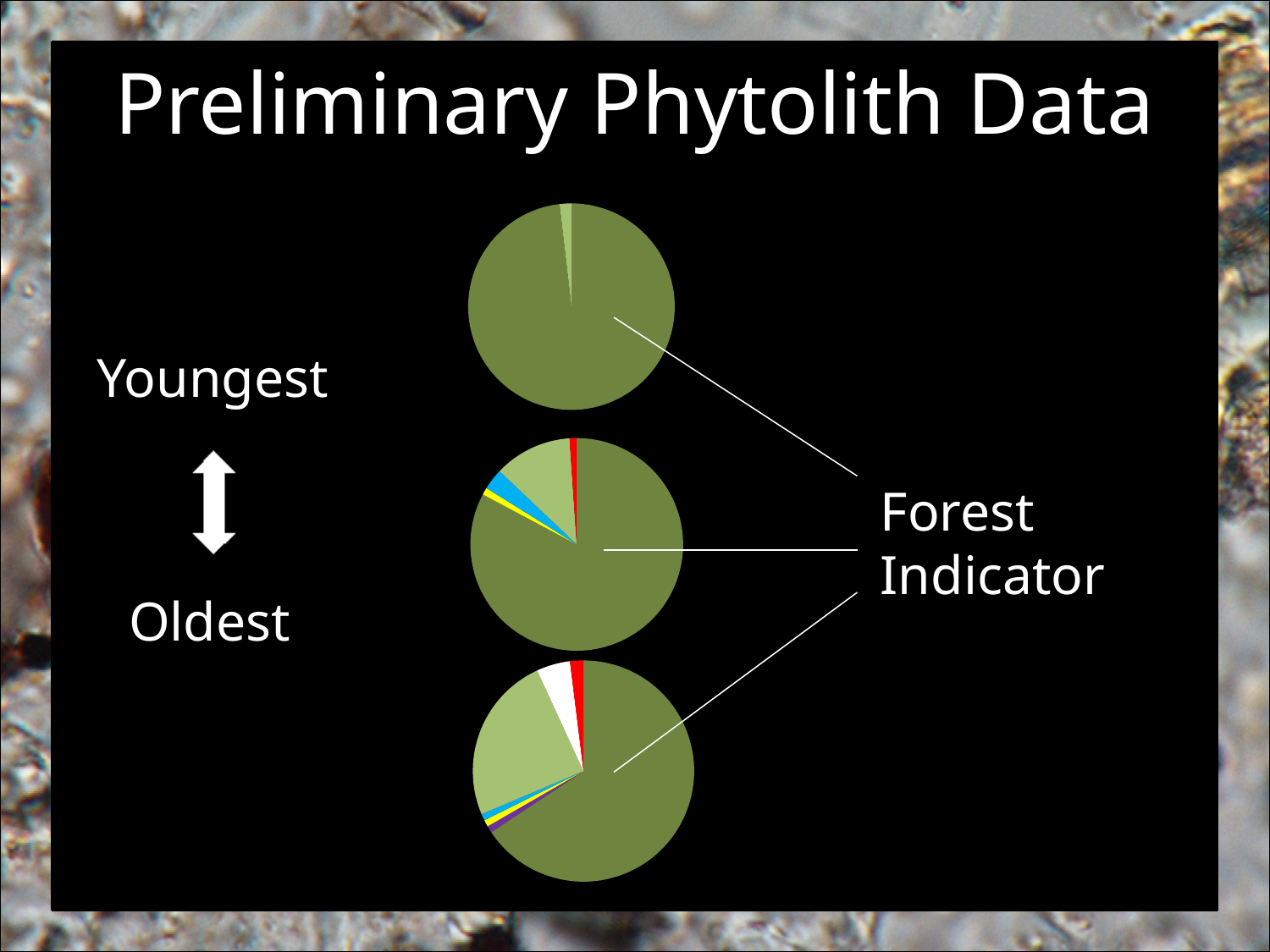
In the middle pie chart, which slice is the largest? Forest Indicator What kind of charts are shown on the slide? Pie charts Which pie chart, top, middle or bottom, represents the youngest sample? Top Does the Forest Indicator share of the pie increase or decrease from the youngest (top) chart to the oldest (bottom) chart? Decrease How many slices does the top pie chart have? 2 How many slices does the middle pie chart have? 5 In the bottom pie chart, which slice is the largest? Forest Indicator What is the title of the slide containing the pie charts? Preliminary Phytolith Data In the top pie chart, which slice is the largest? Forest Indicator Which category do the lines from the three pie charts point to? Forest Indicator In the bottom pie chart, which is larger, the Forest Indicator slice or the light green slice? Forest Indicator How many pie charts are on the slide? 3